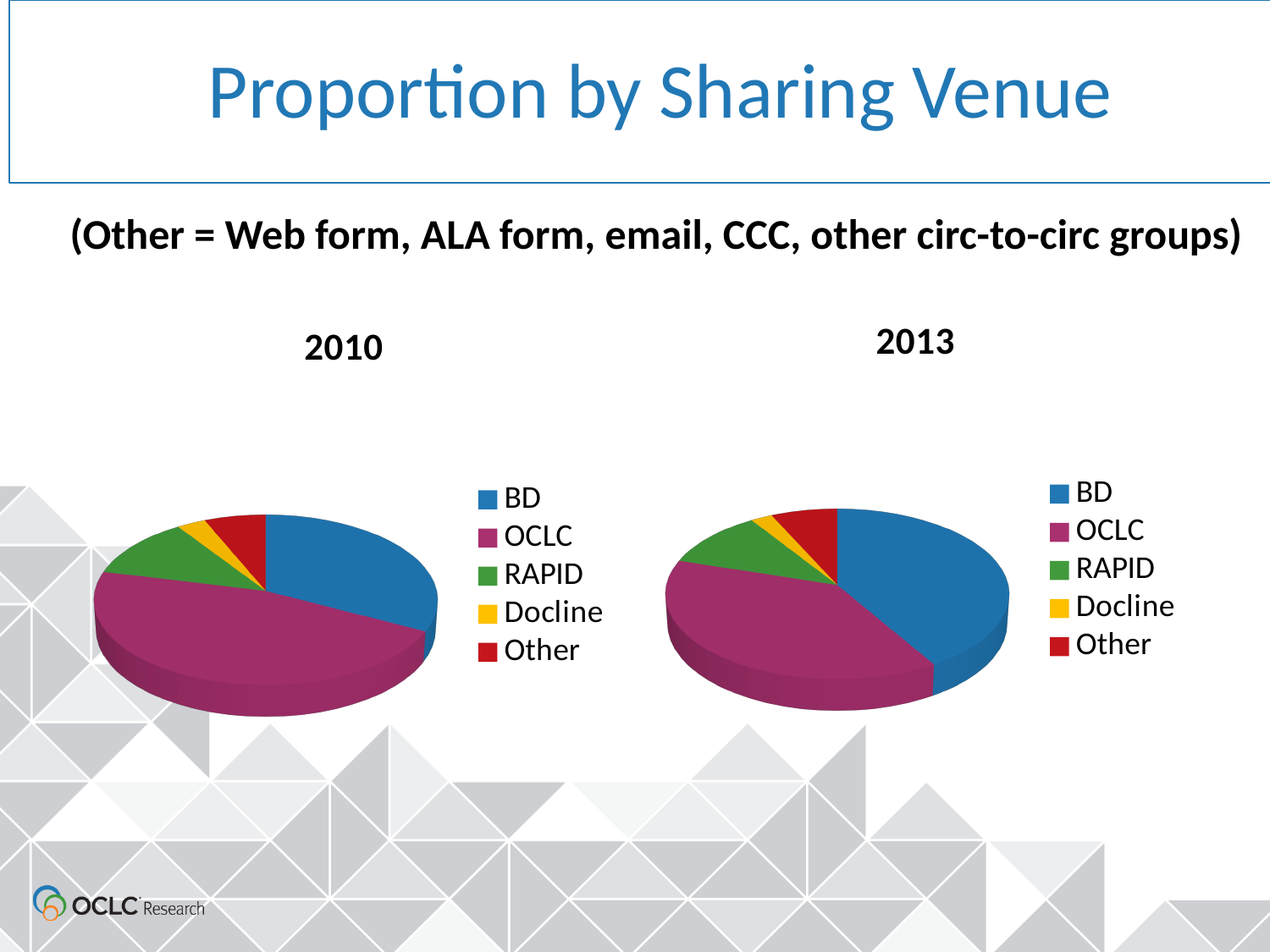
How many categories does the 2010 pie chart show? 5 In the 2013 pie chart, which category has the largest slice? BD In the 2013 pie chart, which is larger, the BD slice or the Other slice? BD What kind of chart is used for the 2010 data? pie chart In the 2010 pie chart, which is larger, the BD slice or the OCLC slice? OCLC In the 2013 pie chart, which category has the smallest slice? Docline How many entries does the legend of the 2013 pie chart list? 5 In the 2010 pie chart, which category has the smallest slice? Docline What is the title of the pie chart on the right? 2013 In the 2010 pie chart, which category has the largest slice? OCLC In the 2010 pie chart, which colour represents OCLC? purple In the 2013 pie chart, which is larger, the RAPID slice or the Docline slice? RAPID